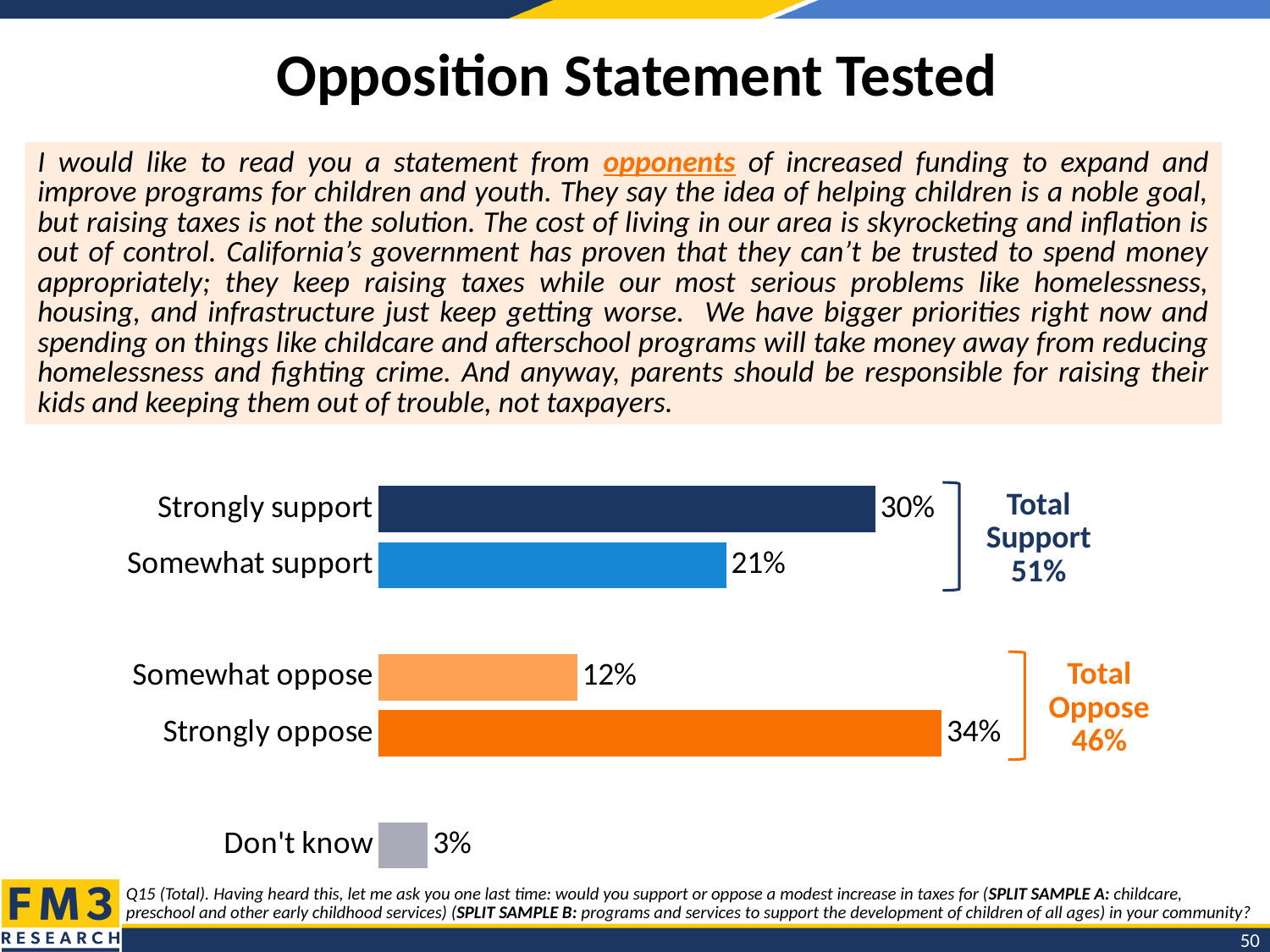
What is the difference between Strongly oppose and Strongly support? 4% What percentage of respondents said they somewhat oppose? 12% What kind of chart is shown on the slide? Bar chart Which category has the lowest value? Don't know What is the value shown for Don't know? 3% Which is larger, Somewhat support or Somewhat oppose? Somewhat support What percentage of respondents said they strongly support? 30% Which category has the highest value? Strongly oppose What is the difference between Somewhat support and Somewhat oppose? 9% What is the Total Oppose percentage shown next to the chart? 46% What is the Total Support percentage shown next to the chart? 51% How many categories are shown in the chart? 5